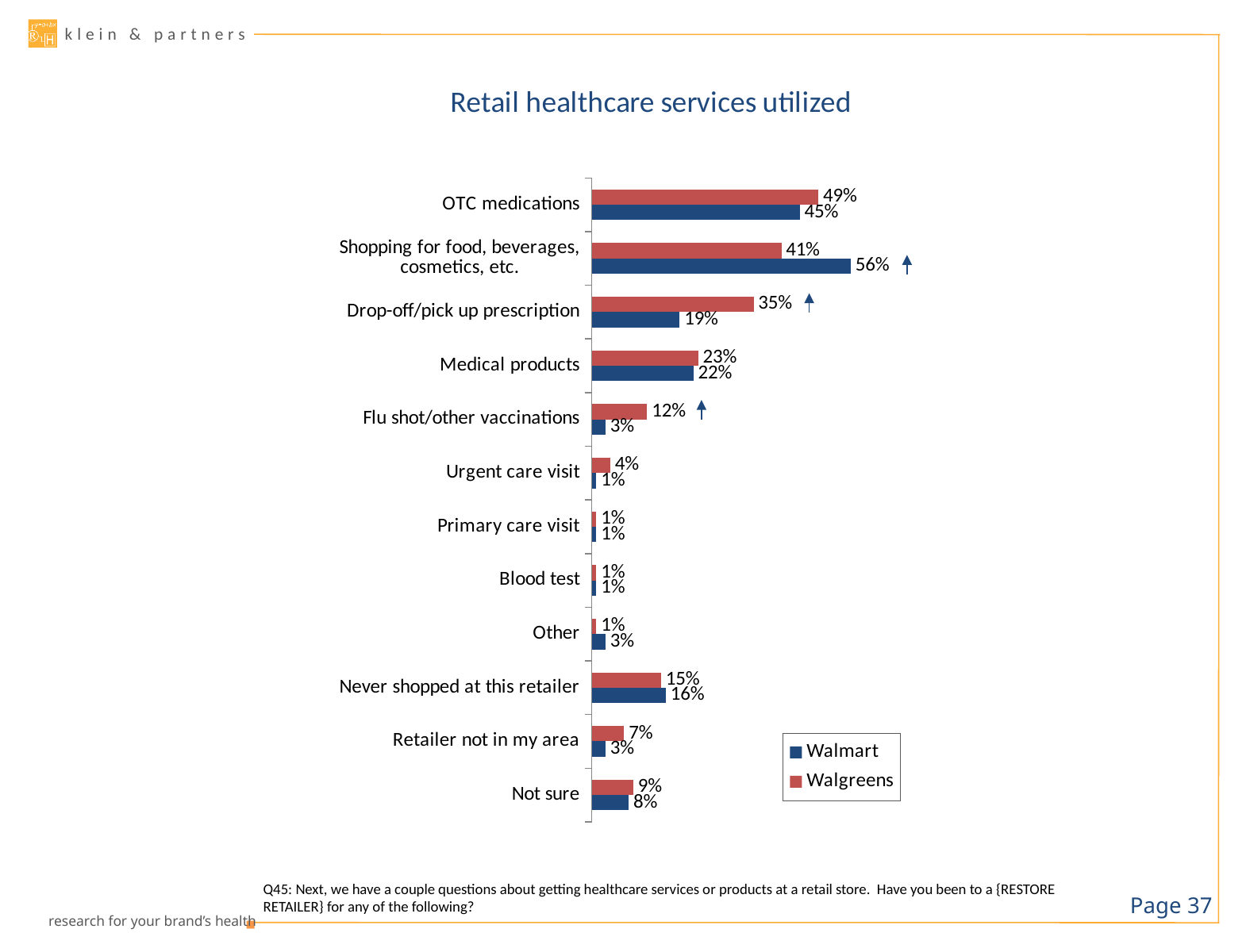
Which category has the highest Walgreens value? OTC medications What is the Walgreens value for Flu shot/other vaccinations? 12% What is the difference between the Walmart and Walgreens values for Shopping for food, beverages, cosmetics, etc.? 15% For OTC medications, which is larger, the Walmart value or the Walgreens value? Walgreens Which series is shown in blue in the legend? Walmart How many categories are shown on the chart? 12 What is the Walmart value for Shopping for food, beverages, cosmetics, etc.? 56% How many series does the legend list? 2 What kind of chart is shown on the slide? Bar chart What is the Walgreens value for Drop-off/pick up prescription? 35% Which category has the highest Walmart value? Shopping for food, beverages, cosmetics, etc. What is the difference between the Walgreens and Walmart values for Drop-off/pick up prescription? 16%